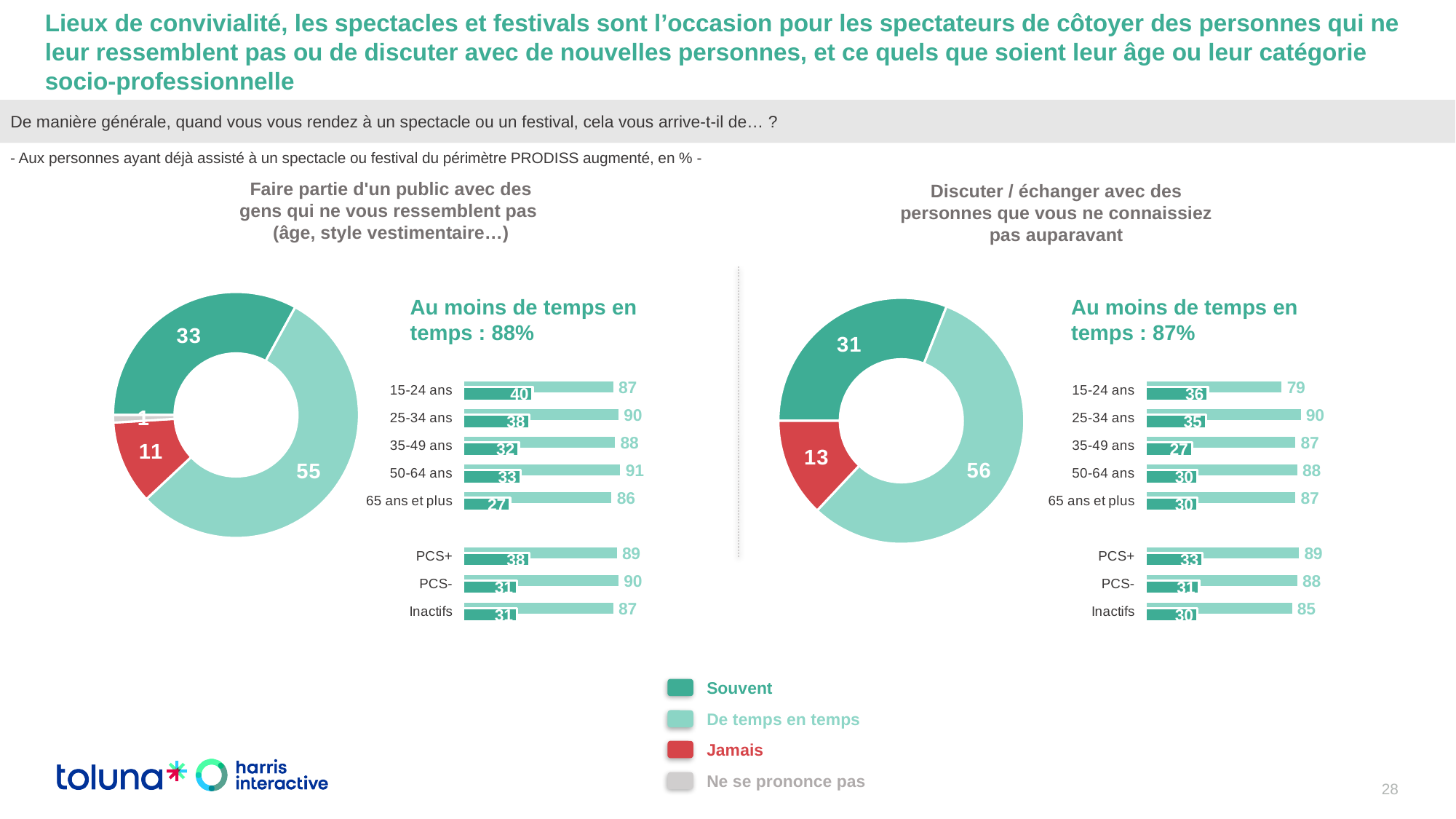
In the right bar chart, which is larger: the total value for PCS+ or for Inactifs? PCS+ In the right bar chart by age, what is the total ("Au moins de temps en temps") value for 15-24 ans? 79 In the right bar chart, which age group has the lowest total value? 15-24 ans What type of chart is used to show the overall distribution for each question on the slide? Donut (pie) chart In the left donut chart ("Faire partie d'un public avec des gens qui ne vous ressemblent pas"), what is the value for "De temps en temps"? 55 In the right donut chart ("Discuter / échanger avec des personnes que vous ne connaissiez pas auparavant"), what is the value for "Jamais"? 13 In the left bar chart by age, what is the "Souvent" value for 15-24 ans? 40 How many entries does the legend at the bottom of the slide list? 4 In the left bar chart, which age group has the highest total value? 50-64 ans In the left donut chart, which category has the smallest share? Ne se prononce pas In the left bar chart, what is the difference between the "Souvent" values for 15-24 ans and 65 ans et plus? 13 In the right donut chart, which category has the largest share? De temps en temps